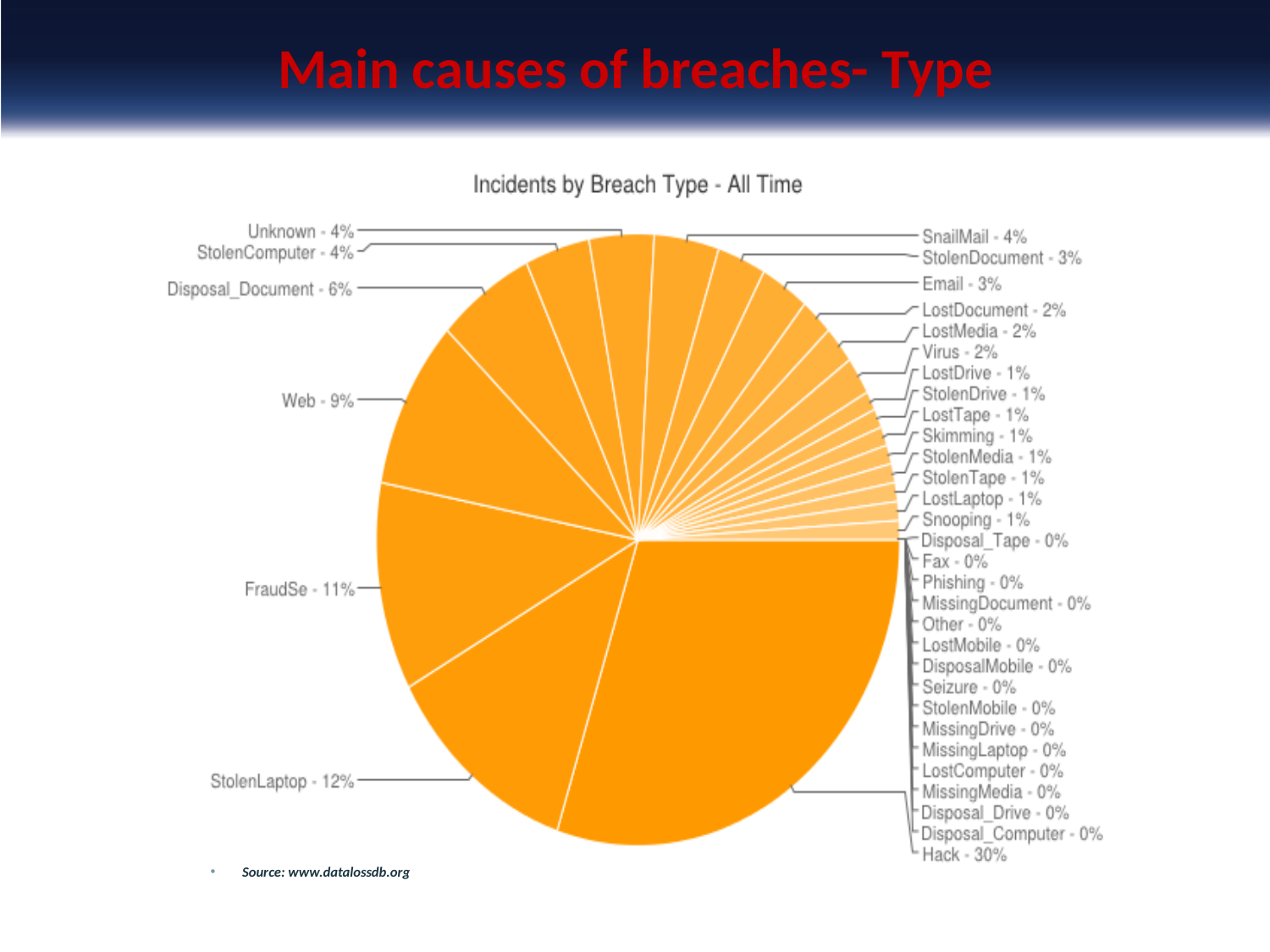
What share of incidents is attributed to Hack? 30% Which has a larger share of incidents, StolenLaptop or FraudSe? StolenLaptop What percentage of incidents is attributed to StolenLaptop? 12% What is the title of the chart? Incidents by Breach Type - All Time How many percentage points larger is the Hack share than the StolenLaptop share? 18 What percentage of incidents is attributed to FraudSe? 11% How many breach types are labelled on the pie chart? 36 What percentage of incidents is attributed to Web? 9% What percentage of incidents is attributed to Virus? 2% Which breach type has the largest share of incidents? Hack What percentage of incidents is attributed to Disposal_Document? 6% What kind of chart is shown on the slide? Pie chart